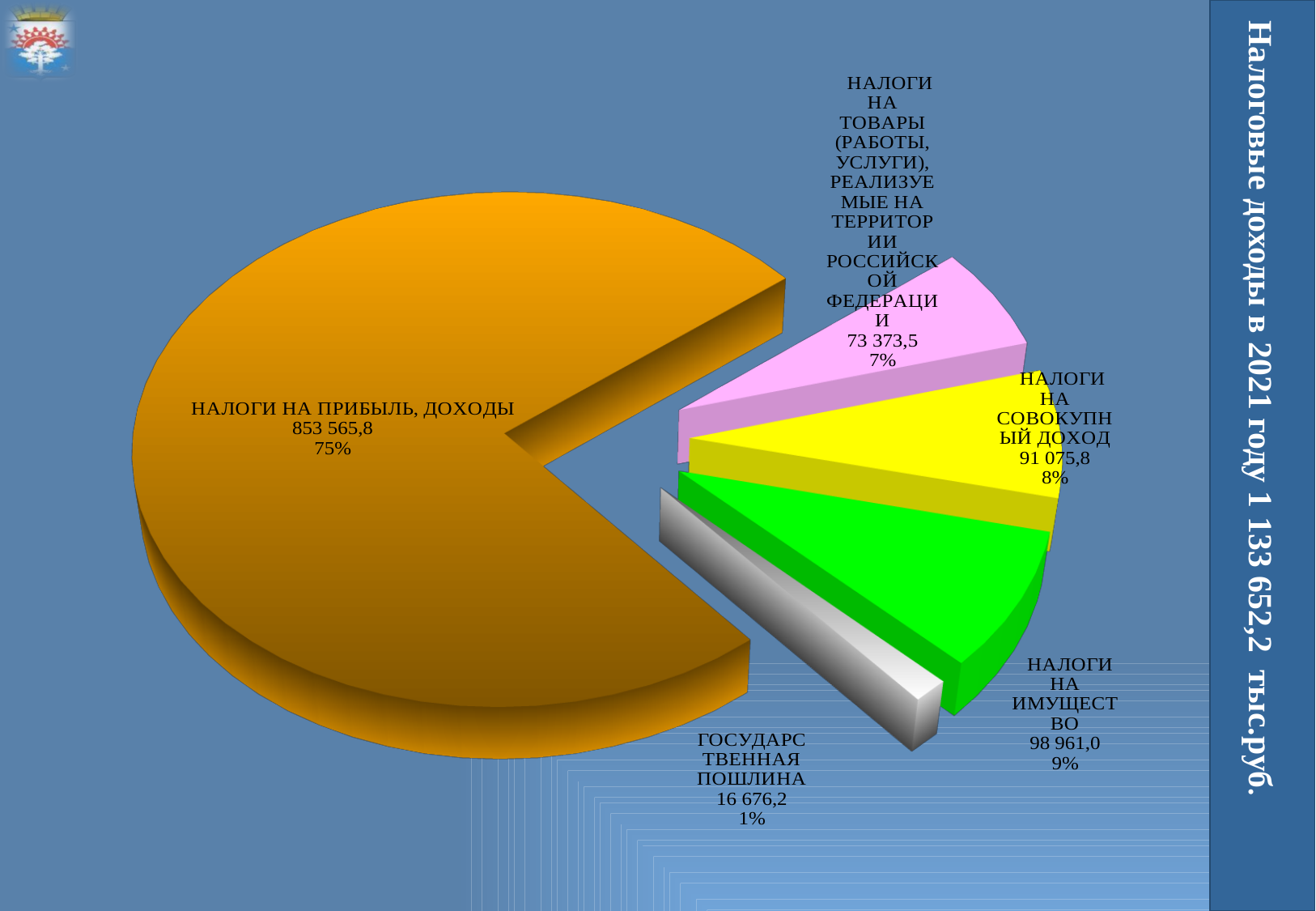
What is the value shown for НАЛОГИ НА ПРИБЫЛЬ, ДОХОДЫ? 853 565,8 What is the value shown for НАЛОГИ НА СОВОКУПНЫЙ ДОХОД? 91 075,8 What is the value shown for ГОСУДАРСТВЕННАЯ ПОШЛИНА? 16 676,2 What share of the pie does НАЛОГИ НА ТОВАРЫ (РАБОТЫ, УСЛУГИ), РЕАЛИЗУЕМЫЕ НА ТЕРРИТОРИИ РОССИЙСКОЙ ФЕДЕРАЦИИ represent? 7% Which is larger: НАЛОГИ НА ИМУЩЕСТВО or НАЛОГИ НА СОВОКУПНЫЙ ДОХОД? НАЛОГИ НА ИМУЩЕСТВО Which category has the largest slice of the pie? НАЛОГИ НА ПРИБЫЛЬ, ДОХОДЫ What is the difference between the values for НАЛОГИ НА ИМУЩЕСТВО and НАЛОГИ НА СОВОКУПНЫЙ ДОХОД? 7 885,2 How many slices does the pie chart have? 5 What kind of chart is shown on the slide? pie chart Which category has the smallest slice of the pie? ГОСУДАРСТВЕННАЯ ПОШЛИНА What is the value shown for НАЛОГИ НА ИМУЩЕСТВО? 98 961,0 What share of the pie does НАЛОГИ НА ПРИБЫЛЬ, ДОХОДЫ represent? 75%